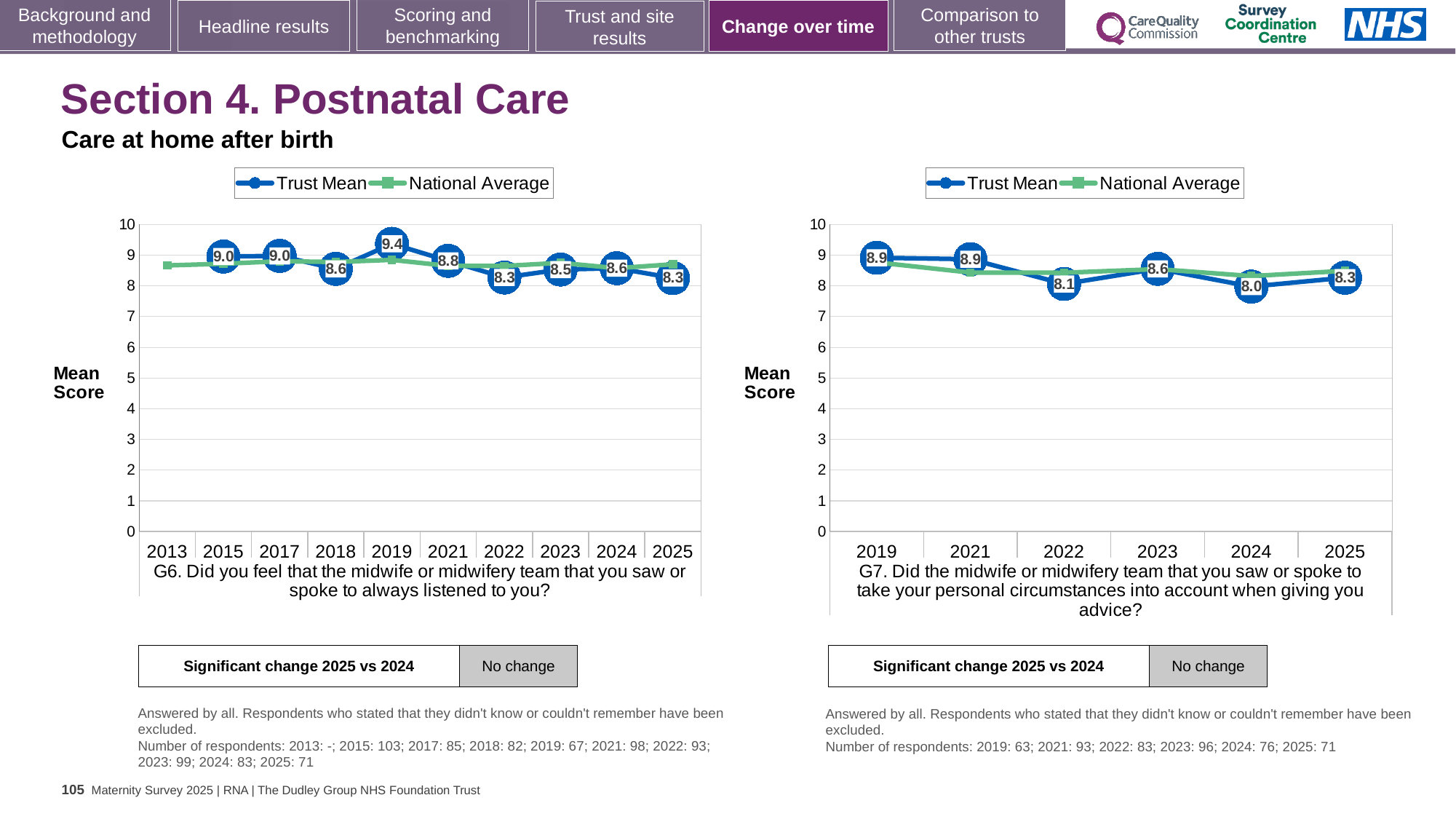
In the left chart (G6), which year has the highest Trust Mean? 2019 What kind of chart is the left chart (G6)? Line chart How many years are shown on the x axis of the right chart (G7)? 6 In the left chart (G6), what is the difference between the Trust Mean in 2019 and in 2025? 1.1 In the right chart (G7), what is the difference between the Trust Mean in 2019 and in 2022? 0.8 In the right chart (G7), does the Trust Mean rise or fall from 2023 to 2024? fall In the right chart (G7), which year has the lowest Trust Mean? 2024 In the right chart (G7), what is the Trust Mean for 2024? 8.0 In the right chart (G7), which is larger, the Trust Mean for 2023 or for 2025? 2023 How many series does the legend of the left chart (G6) list? 2 In the left chart (G6), what is the Trust Mean for 2019? 9.4 In the left chart (G6), is the Trust Mean for 2022 greater or less than 9? less